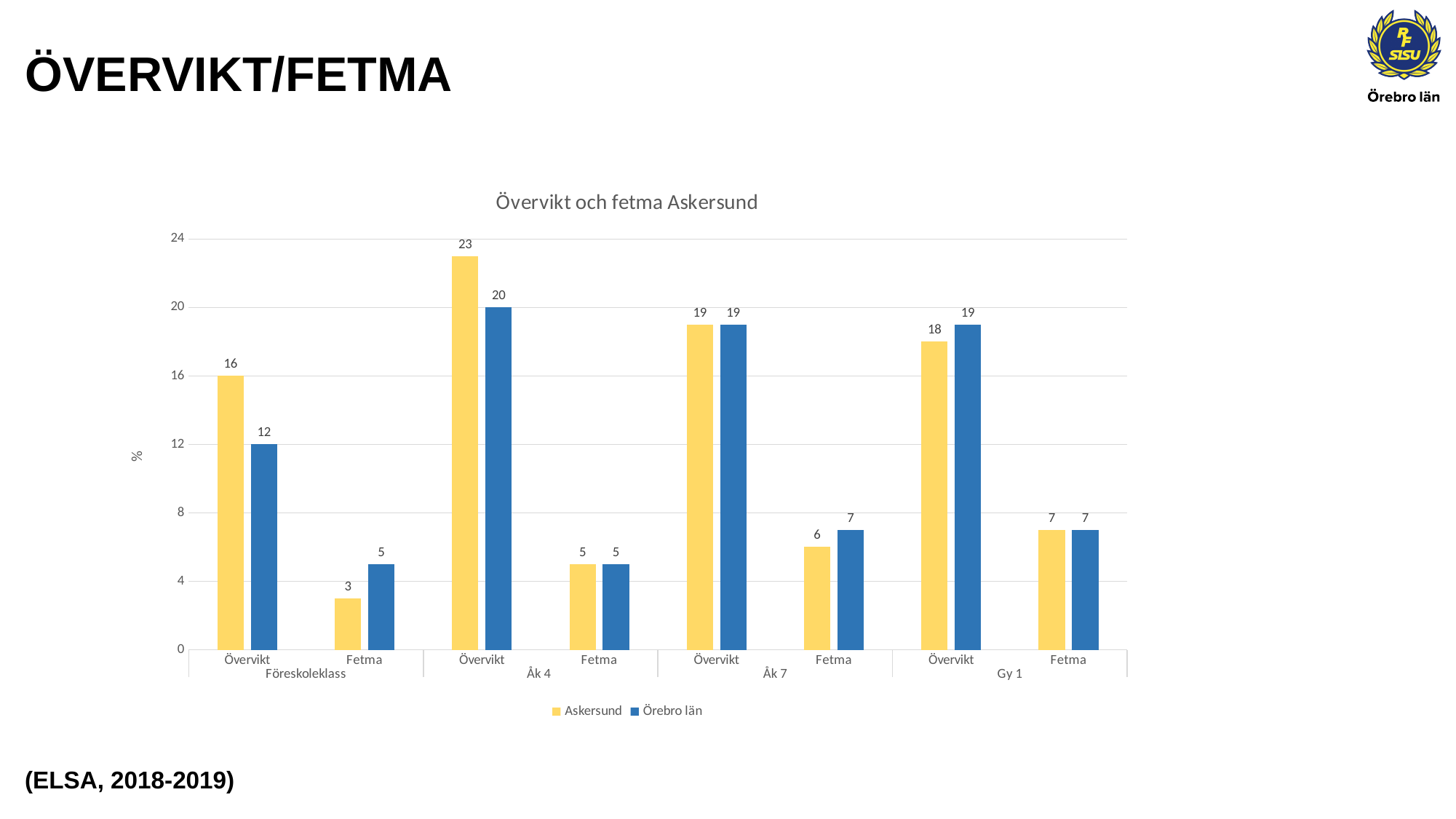
What is the value for Askersund for Övervikt in Förskoleklass? 16 Which category has the highest value for Askersund? Övervikt, Åk 4 What colour are the bars for Örebro län? Blue How many series does the legend list? 2 Which category has the lowest value for Askersund? Fetma, Förskoleklass What is the value for Örebro län for Fetma in Åk 4? 5 Which is larger for Fetma in Åk 7: Askersund or Örebro län? Örebro län What kind of chart is shown? Bar chart What is the value for Askersund for Övervikt in Gy 1? 18 What is the title of the chart? Övervikt och fetma Askersund Which is larger for Övervikt in Åk 4: Askersund or Örebro län? Askersund What is the difference between Askersund and Örebro län for Övervikt in Förskoleklass? 4